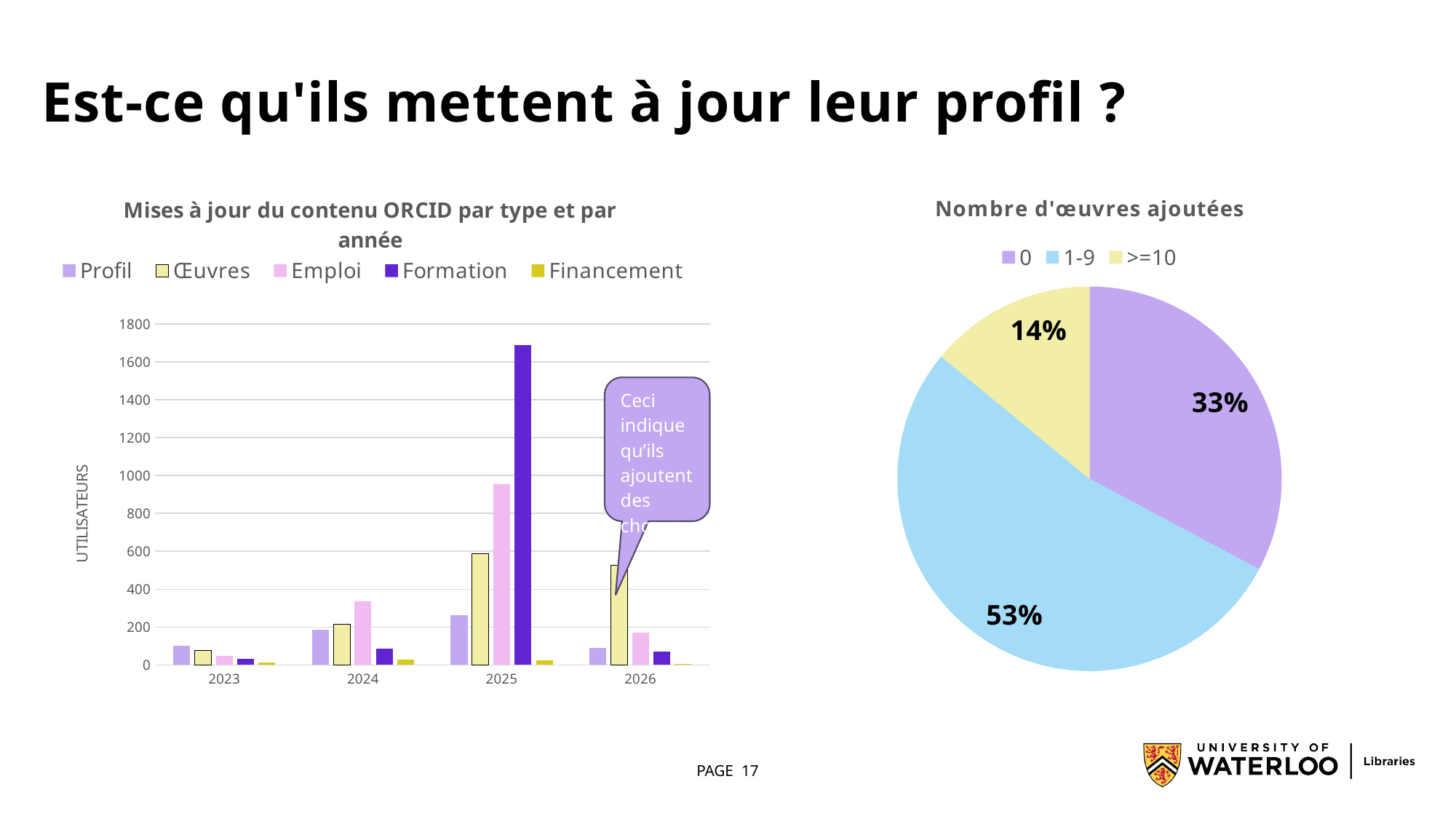
In the pie chart 'Nombre d'œuvres ajoutées', which category has the smallest slice? >=10 In the pie chart 'Nombre d'œuvres ajoutées', what share is labelled for the '0' slice? 33% In the pie chart 'Nombre d'œuvres ajoutées', which category has the largest slice? 1-9 What kind of chart is 'Mises à jour du contenu ORCID par type et par année'? Bar chart In the bar chart 'Mises à jour du contenu ORCID par type et par année', is the value for Formation in 2025 greater or less than 1600? greater In the pie chart 'Nombre d'œuvres ajoutées', what is the difference in percentage points between the '1-9' slice and the '>=10' slice? 39 percentage points In the pie chart 'Nombre d'œuvres ajoutées', what share is labelled for the '1-9' slice? 53% In the bar chart 'Mises à jour du contenu ORCID par type et par année', which series has the tallest bar in 2025? Formation In the bar chart 'Mises à jour du contenu ORCID par type et par année', does the Formation series rise or fall from 2023 to 2025? Rise How many slices does the pie chart 'Nombre d'œuvres ajoutées' have? 3 In the bar chart 'Mises à jour du contenu ORCID par type et par année', is the value for Emploi in 2025 greater or less than 1000? less How many series does the legend of the bar chart 'Mises à jour du contenu ORCID par type et par année' list? 5